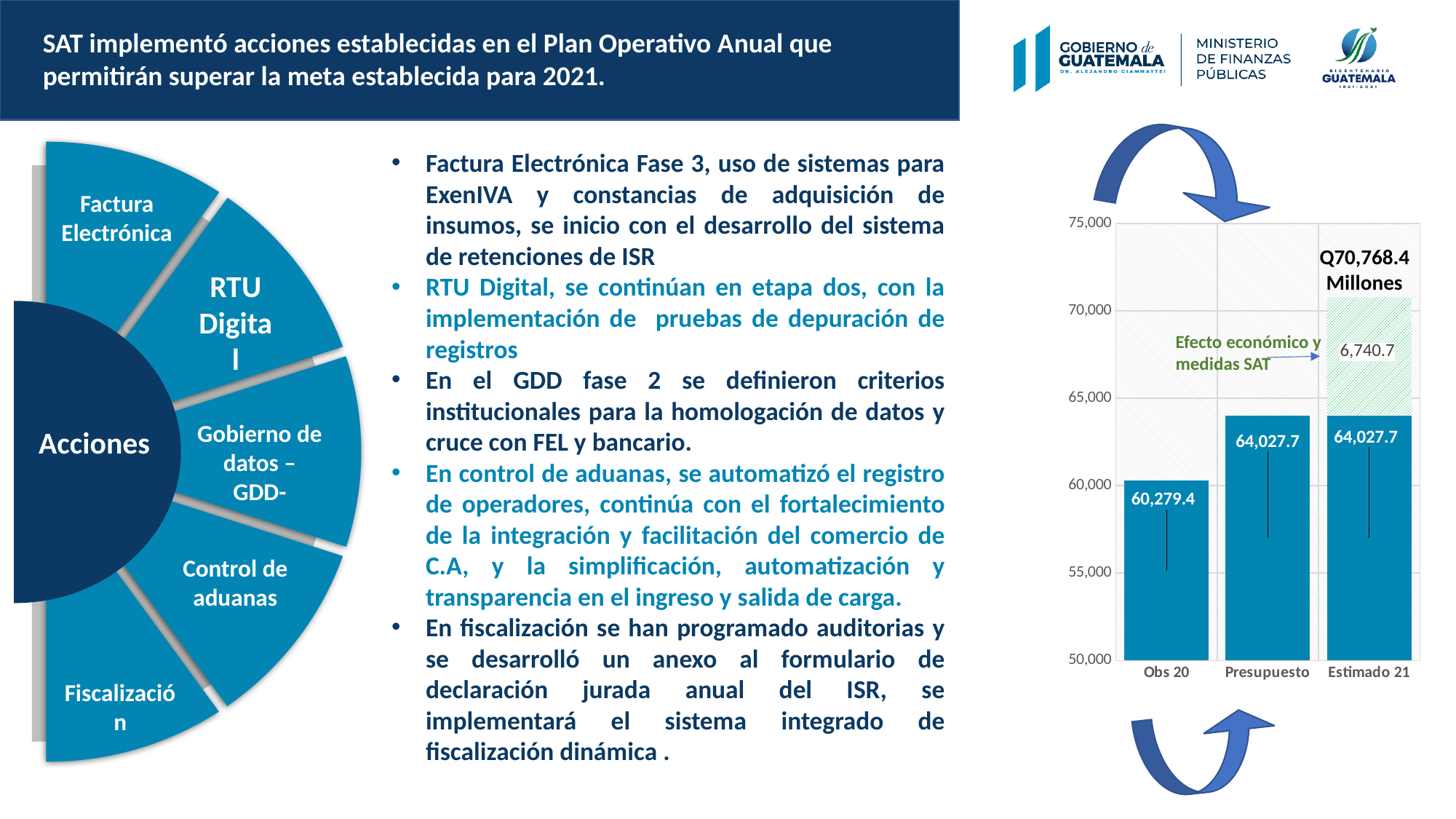
In the bar chart, what is the difference between the Presupuesto value and the Obs 20 value? 3,748.3 In the bar chart, what is the value for Obs 20? 60,279.4 In the bar chart, which category has the lowest value? Obs 20 In the bar chart, is the value for Obs 20 greater or less than 65,000? less In the bar chart, what is the value for Presupuesto? 64,027.7 In the bar chart, what is the total of the stacked Estimado 21 bar? Q70,768.4 Millones In the bar chart, what is the value of the upper segment of the Estimado 21 bar labelled 'Efecto económico y medidas SAT'? 6,740.7 In the bar chart, which category has the highest total bar? Estimado 21 How many categories are shown on the x axis of the bar chart? 3 In the bar chart, do the total bar heights rise or fall from Obs 20 to Estimado 21? Rise What kind of chart is shown on the right side of the slide? Bar chart In the bar chart, what is the value of the lower (solid) segment of the Estimado 21 bar? 64,027.7